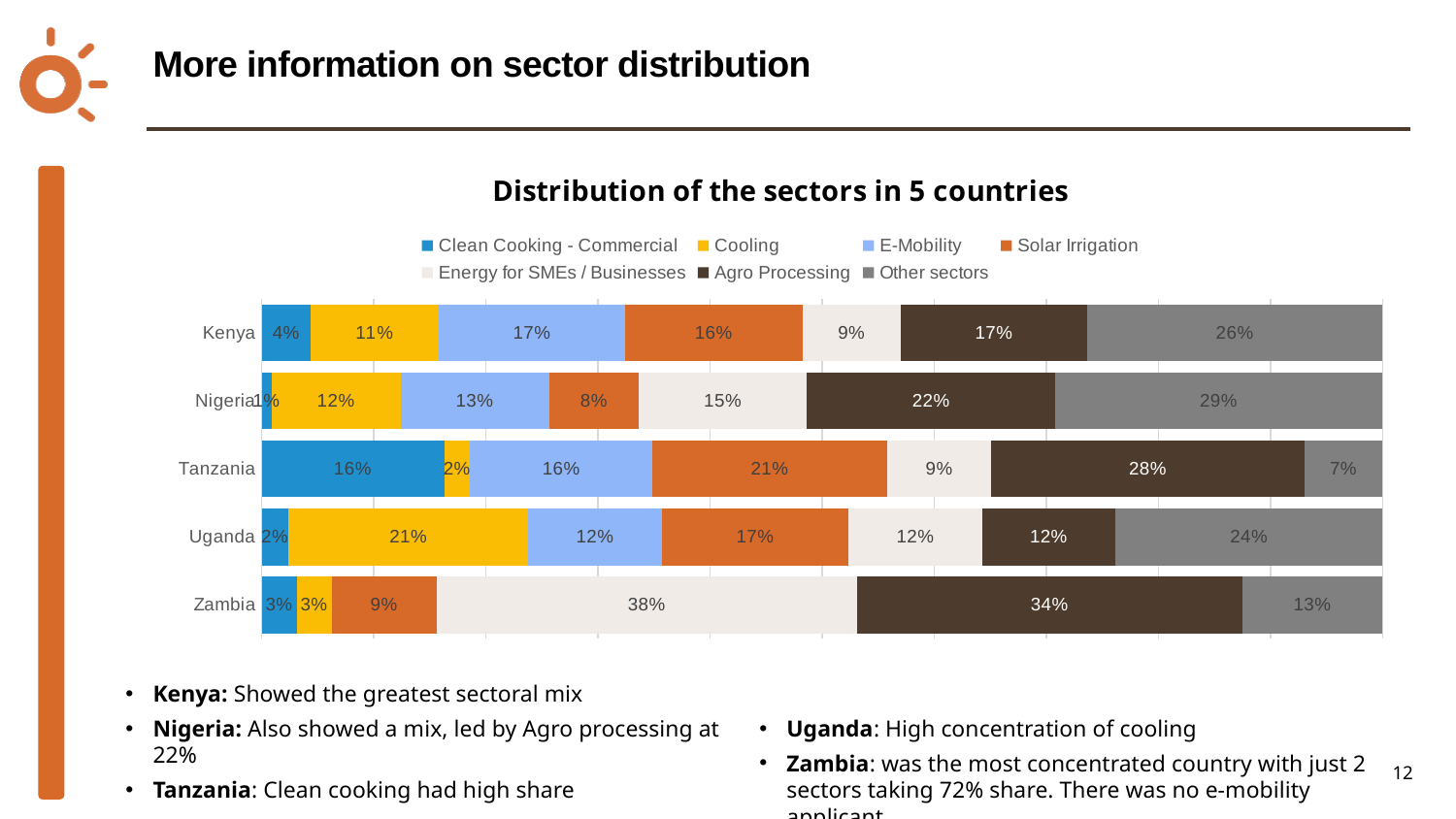
Which country has the lowest Other sectors value? Tanzania What kind of chart is shown on the slide? Stacked bar chart What is the difference between the Other sectors values for Nigeria and Kenya? 3% What is the Energy for SMEs / Businesses value for Zambia? 38% Which country has the highest Agro Processing value? Zambia How many series does the legend list? 7 Which is larger, the Solar Irrigation value for Tanzania or for Kenya? Tanzania What is the title of the chart? Distribution of the sectors in 5 countries What is the Clean Cooking - Commercial value for Tanzania? 16% What is the Cooling value for Uganda? 21% How many countries are shown on the chart? 5 What is the Agro Processing value for Nigeria? 22%